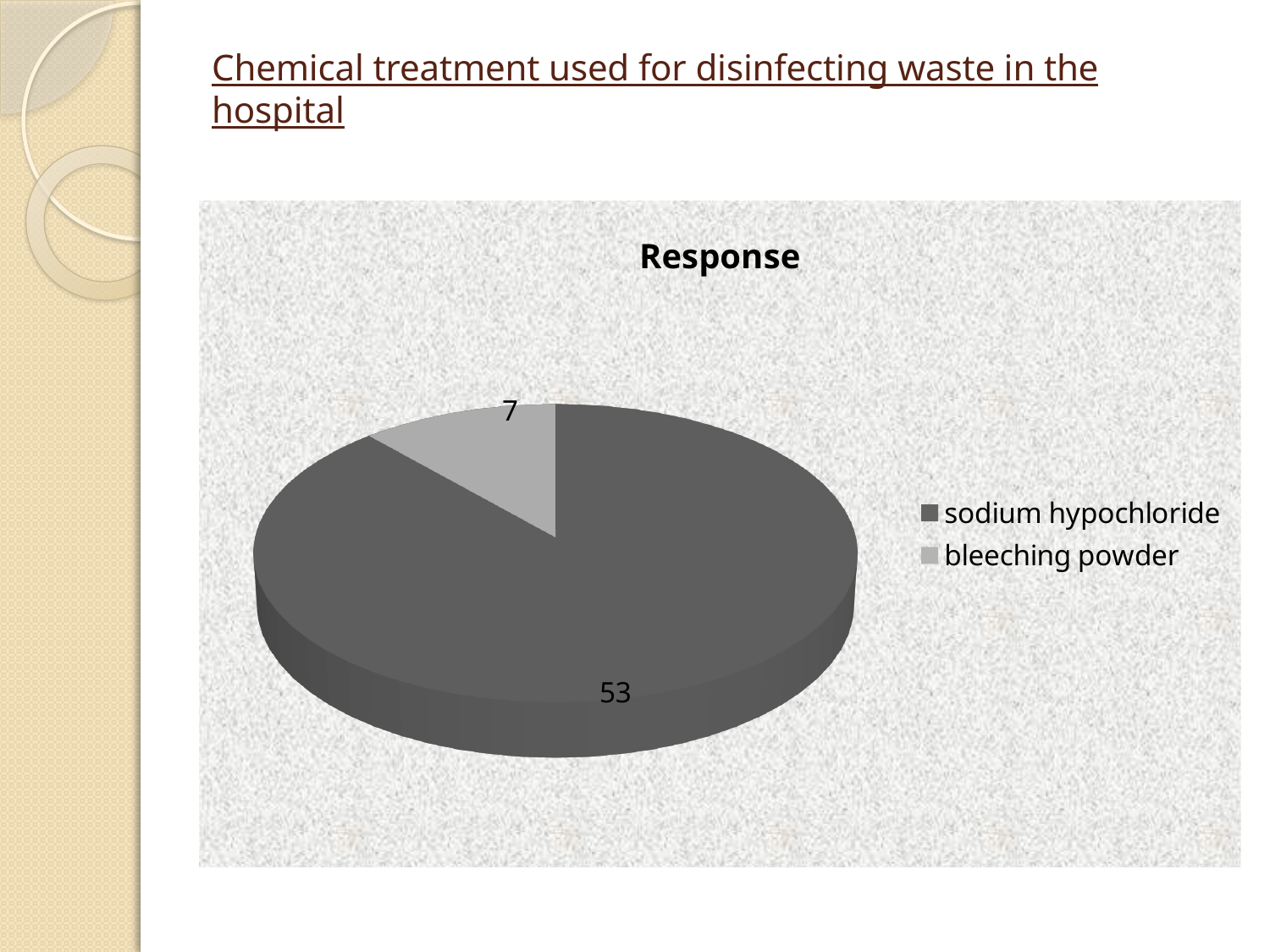
What kind of chart is shown on the slide? pie chart What is the total of all slices in the pie chart? 60 Which is larger, the value for sodium hypochloride or the value for bleeching powder? sodium hypochloride What is the value for bleeching powder? 7 What is the value for sodium hypochloride? 53 How many entries does the legend list? 2 What is the difference between the values for sodium hypochloride and bleeching powder? 46 What is the title of the chart? Response Which category has the largest slice? sodium hypochloride How many slices does the pie chart have? 2 Which category has the smallest slice? bleeching powder Which legend entry is shown in the lighter grey colour? bleeching powder